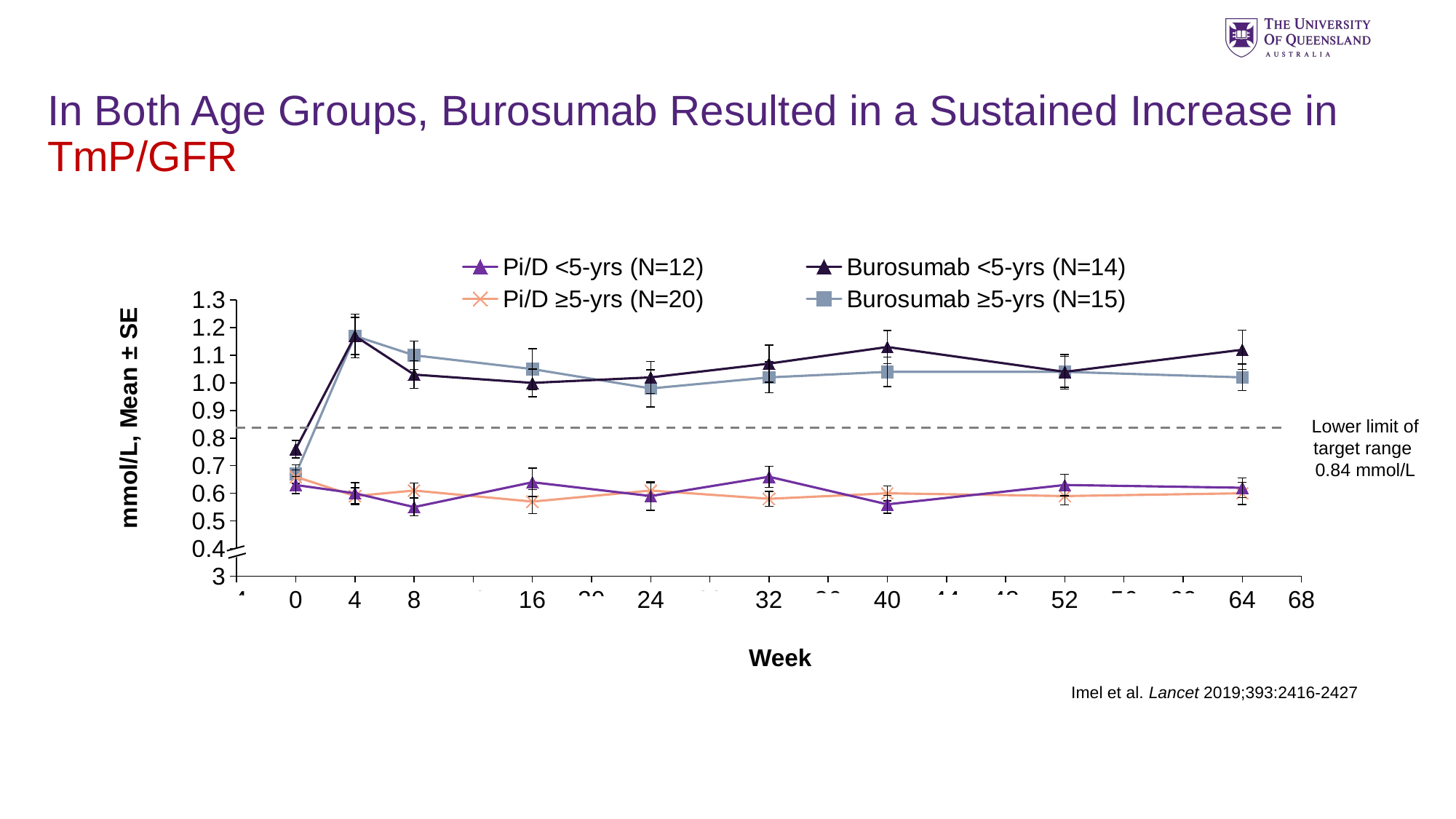
Is the value for Burosumab <5-yrs (N=14) at week 4 greater or less than 1.0? greater Which series has the highest value at week 40? Burosumab <5-yrs (N=14) What value is given for the lower limit of the target range marked by the dashed line? 0.84 mmol/L Is the value for Pi/D ≥5-yrs (N=20) at week 0 greater or less than 0.8? less At week 40, which is larger: Burosumab <5-yrs (N=14) or Burosumab ≥5-yrs (N=15)? Burosumab <5-yrs (N=14) At week 4, which is larger: Burosumab <5-yrs (N=14) or Pi/D <5-yrs (N=12)? Burosumab <5-yrs (N=14) What is the label of the y axis? mmol/L, Mean ± SE How many series does the legend list? 4 Is the value for Pi/D <5-yrs (N=12) at week 8 greater or less than 0.7? less Does the value for Burosumab ≥5-yrs (N=15) rise or fall from week 0 to week 4? rise What kind of chart is shown on the slide? line chart